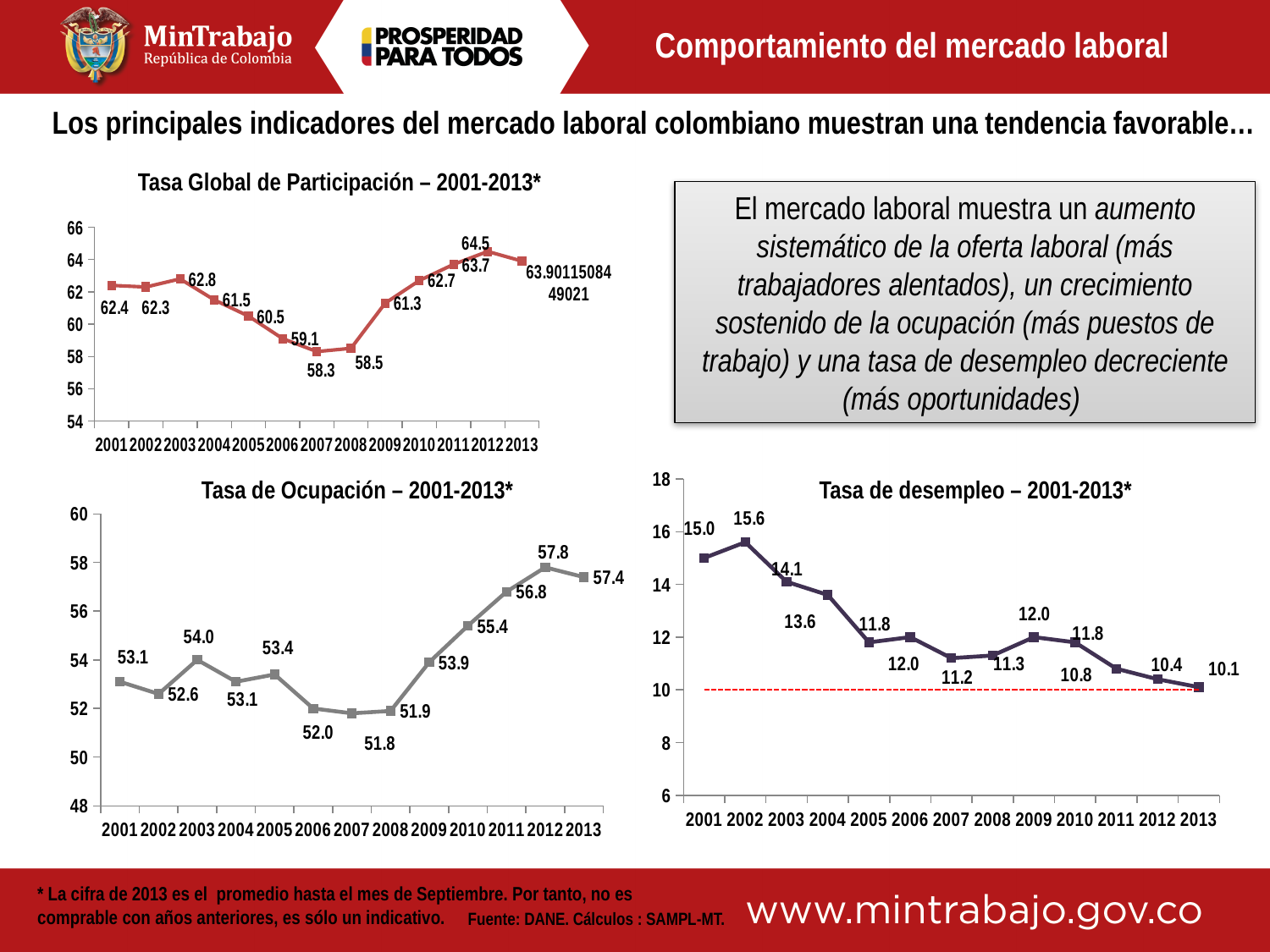
In the 'Tasa de desempleo – 2001-2013*' chart, is the value for 2004 greater or less than 12? greater In the 'Tasa Global de Participación – 2001-2013*' chart, what is the value for 2007? 58.3 In the 'Tasa de Ocupación – 2001-2013*' chart, what is the value for 2010? 55.4 In the 'Tasa Global de Participación – 2001-2013*' chart, which year has the highest value? 2012 In the 'Tasa de Ocupación – 2001-2013*' chart, which year has the lowest value? 2007 What kind of chart is the 'Tasa de desempleo – 2001-2013*' chart? Line chart In the 'Tasa de desempleo – 2001-2013*' chart, what is the difference between the 2001 value and the 2013 value? 4.9 In the 'Tasa de desempleo – 2001-2013*' chart, what is the value for 2002? 15.6 In the 'Tasa de Ocupación – 2001-2013*' chart, which is larger, the value for 2003 or the value for 2005? 2003 In the 'Tasa Global de Participación – 2001-2013*' chart, what is the difference between the 2012 value and the 2007 value? 6.2 How many years are plotted in the 'Tasa de Ocupación – 2001-2013*' chart? 13 In the 'Tasa de desempleo – 2001-2013*' chart, which year has the lowest value? 2013